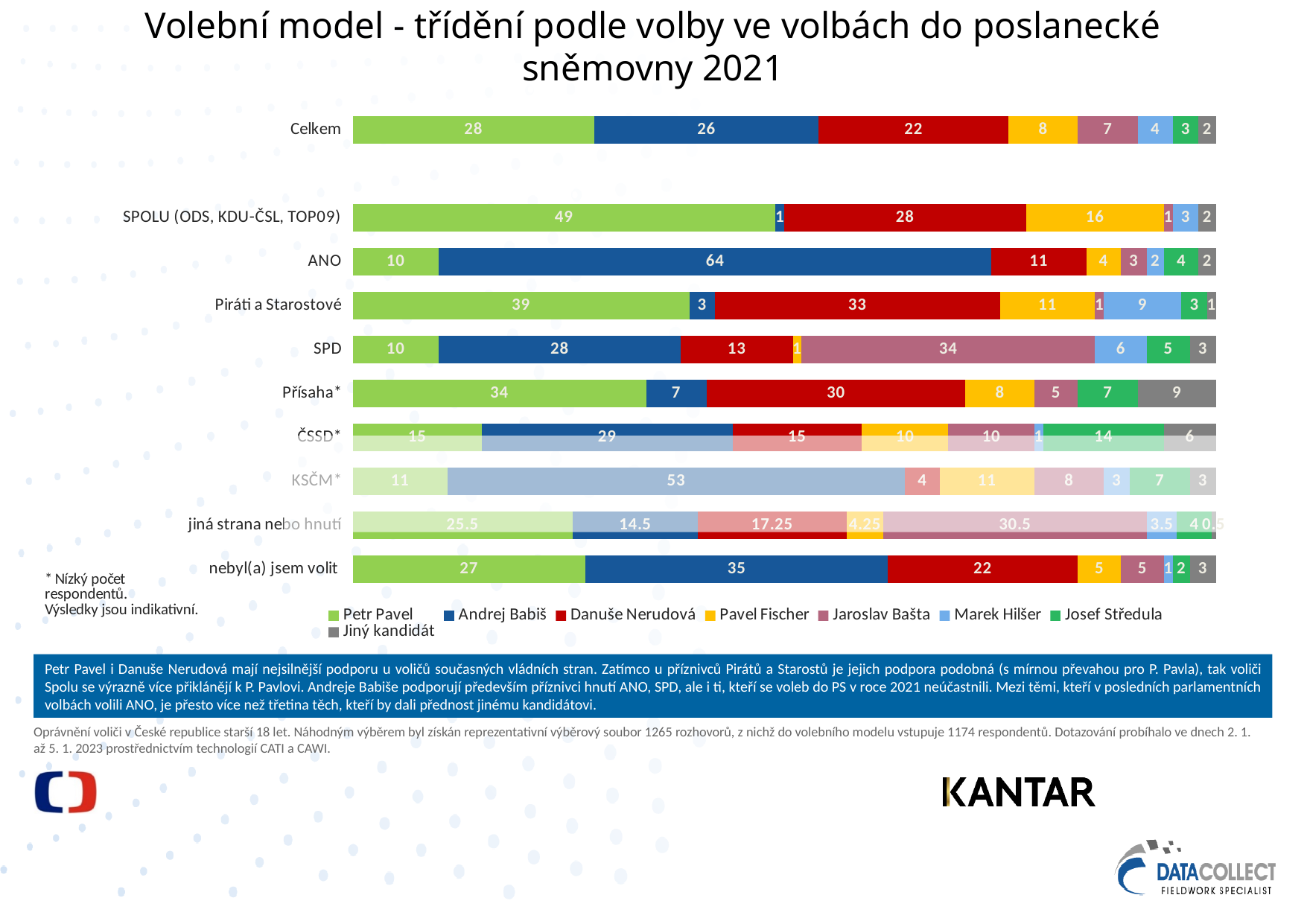
Which voter group has the highest value for Petr Pavel? SPOLU (ODS, KDU-ČSL, TOP09) Among those who did not vote (nebyl(a) jsem volit), which is larger: the value for Andrej Babiš or for Petr Pavel? Andrej Babiš How many voter groups (categories) are plotted on the chart? 10 How many series does the legend list? 8 What is the difference between Petr Pavel and Danuše Nerudová among SPOLU voters? 21 What kind of chart is shown on the slide? stacked bar chart What is the value for Jaroslav Bašta among SPD voters? 34 What is the value for Petr Pavel in the Celkem bar? 28 Which series is shown in red in the legend? Danuše Nerudová Which voter group has the lowest value for Andrej Babiš? SPOLU (ODS, KDU-ČSL, TOP09) What is the value for Andrej Babiš among ANO voters? 64 What is the value for Danuše Nerudová among Piráti a Starostové voters? 33